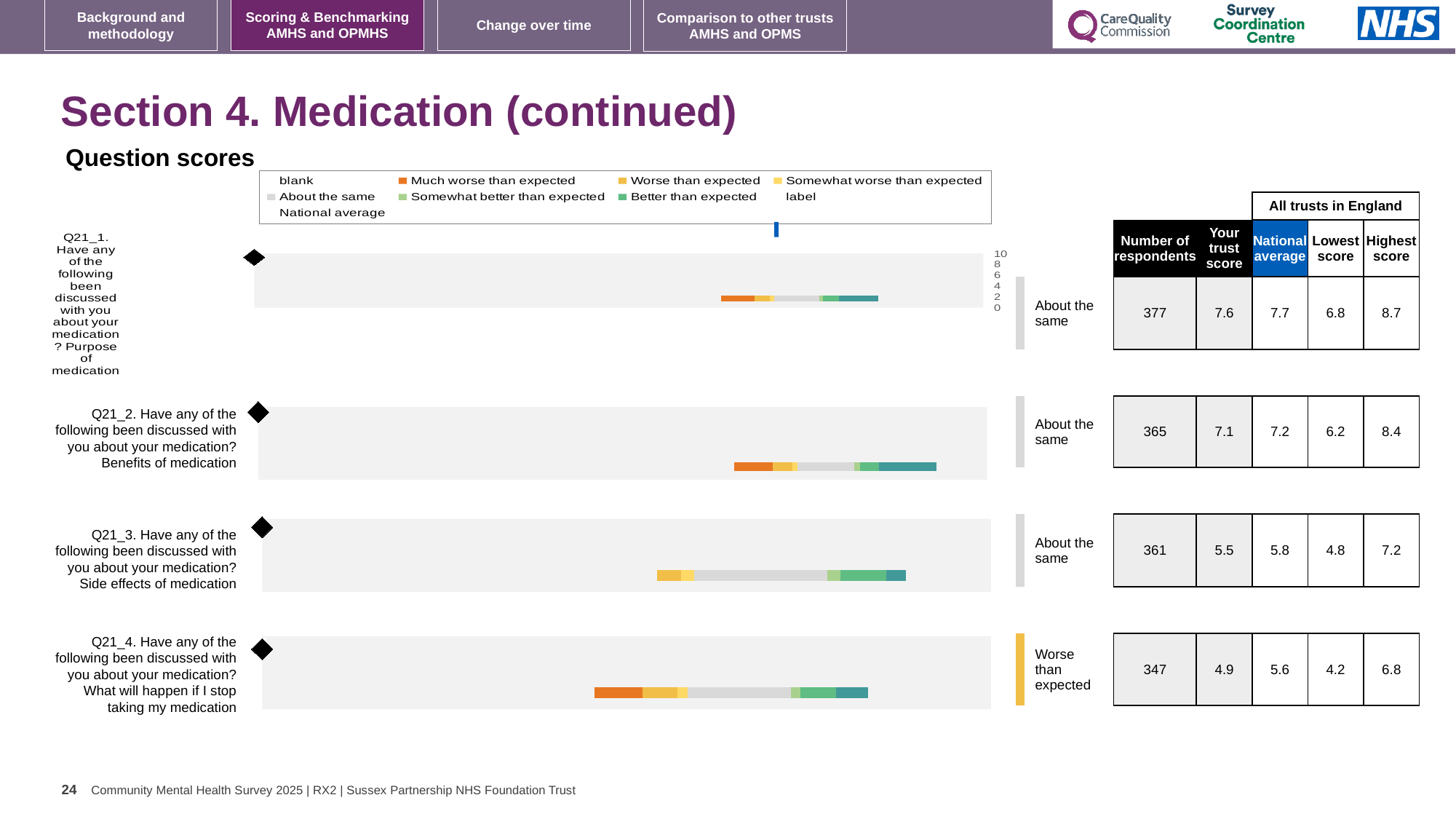
How many questions (bars) are shown in the question scores chart? 4 What is the highest score across all trusts in England for Q21_2 (Benefits of medication)? 8.4 Which question has the lowest trust score? Q21_4 (What will happen if I stop taking my medication) How many of the four questions are rated 'About the same'? 3 What benchmark rating is shown for Q21_4 (What will happen if I stop taking my medication)? Worse than expected What kind of chart is used to show the question scores on this slide? bar chart What is the difference between the highest score and the lowest score for Q21_4? 2.6 How many respondents answered Q21_4 (What will happen if I stop taking my medication)? 347 Which question has the highest trust score? Q21_1 (Purpose of medication) What is the national average for Q21_3 (Side effects of medication)? 5.8 For Q21_1, which is larger: the trust score or the national average? National average What is the trust score for Q21_1 (Purpose of medication)? 7.6